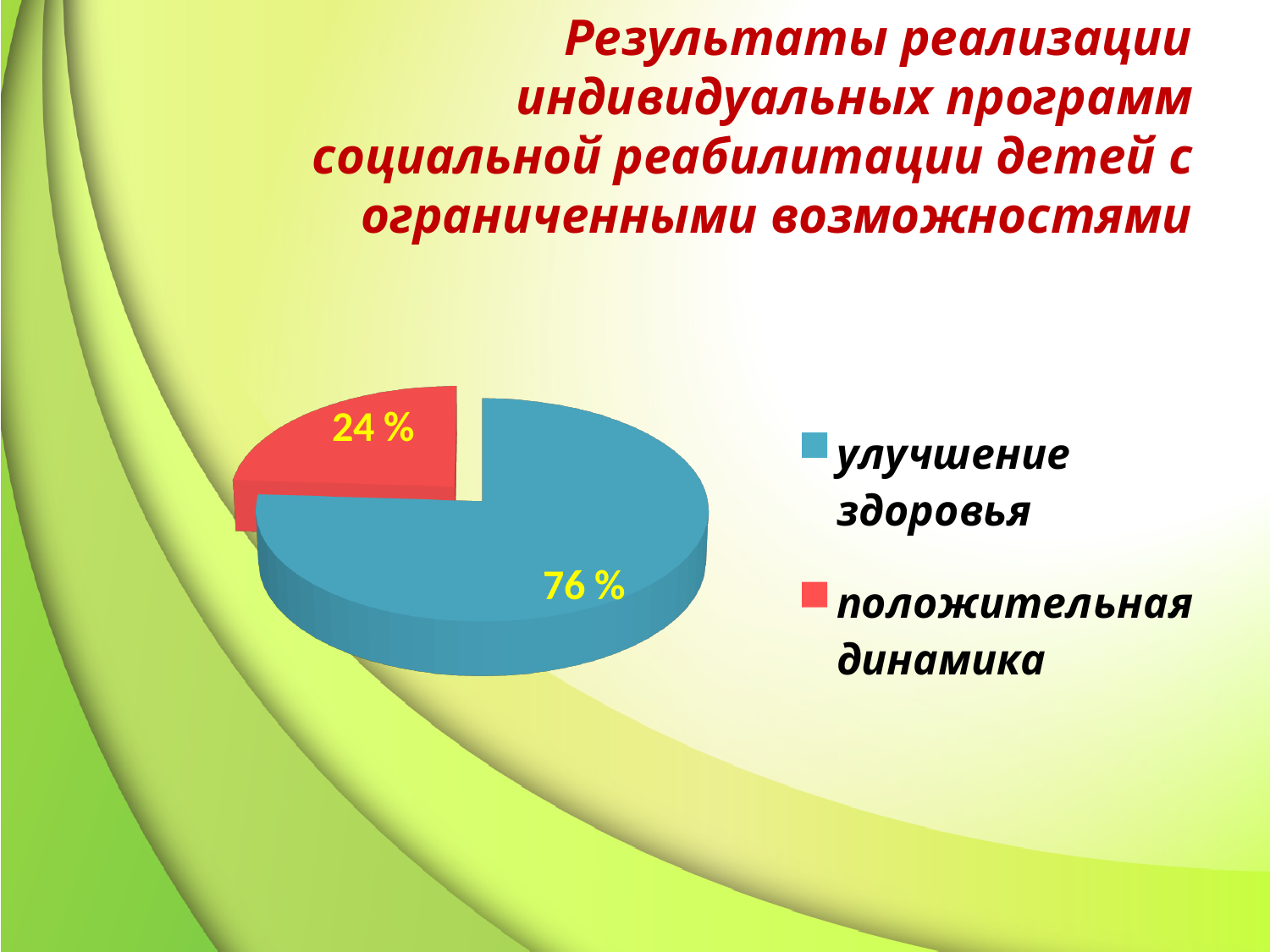
Which category has the smallest slice? положительная динамика What is the value for улучшение здоровья? 76 % What colour is the slice for улучшение здоровья? blue Which category has the largest slice? улучшение здоровья What kind of chart is shown on the slide? pie chart What is the difference between the values for улучшение здоровья and положительная динамика? 52 % How many slices does the pie chart have? 2 How many entries does the legend list? 2 Which is larger: улучшение здоровья or положительная динамика? улучшение здоровья What colour is the slice for положительная динамика? red What share of the pie does положительная динамика take? 24 % What is the value for положительная динамика? 24 %